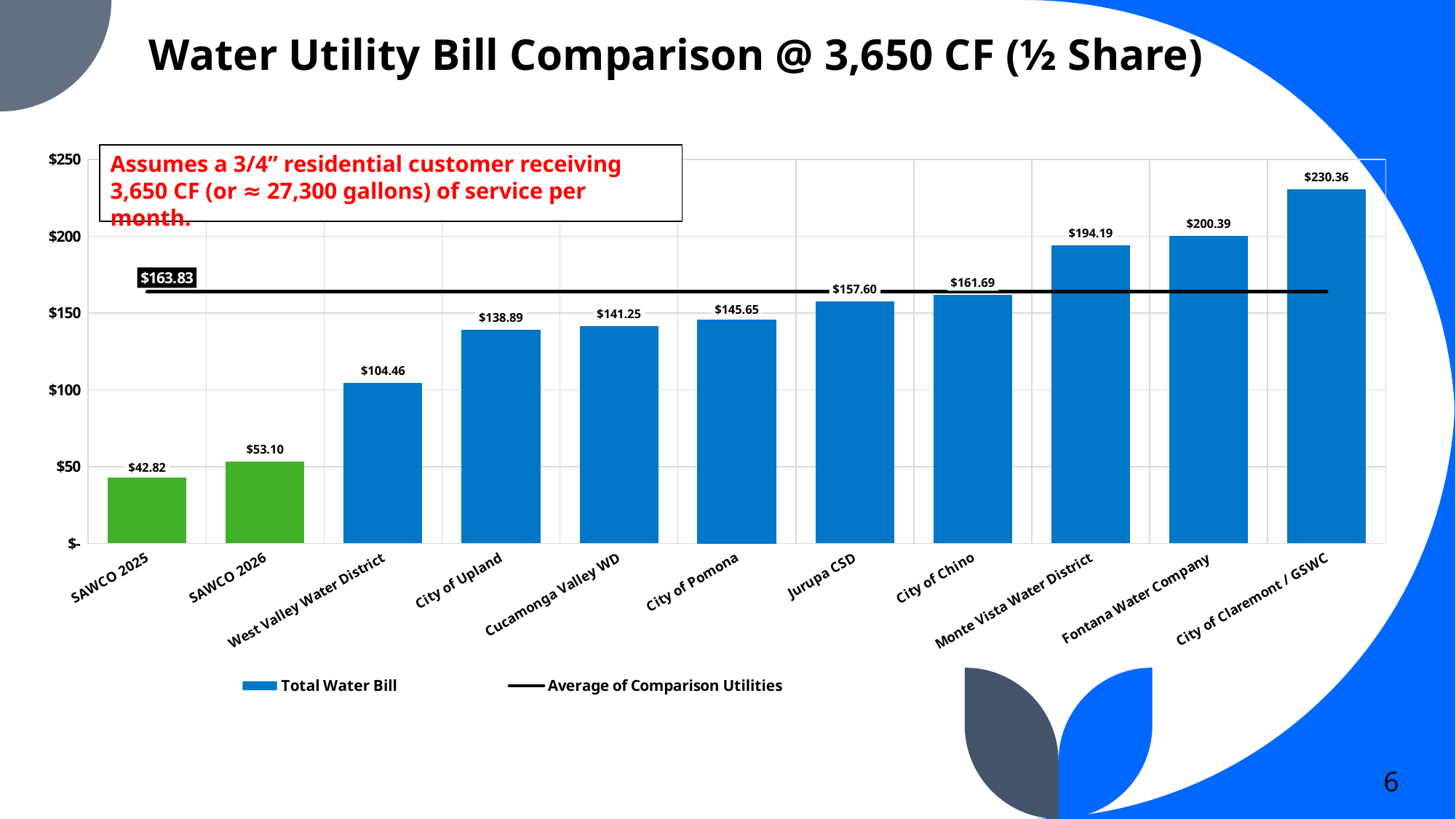
Which has a higher total water bill, Monte Vista Water District or Fontana Water Company? Fontana Water Company Is the total water bill for West Valley Water District greater or less than $100? greater What kind of chart is shown on the slide? Bar chart What is the difference between the total water bill for SAWCO 2026 and SAWCO 2025? $10.28 Which category has the lowest total water bill? SAWCO 2025 How many series does the legend list? 2 What is the total water bill for SAWCO 2026? $53.10 How many categories are shown on the x axis? 11 What is the value of the Average of Comparison Utilities line? $163.83 Which utility has the highest total water bill? City of Claremont / GSWC What is the total water bill for City of Pomona? $145.65 Do the total water bill values rise or fall from left to right along the x axis? Rise